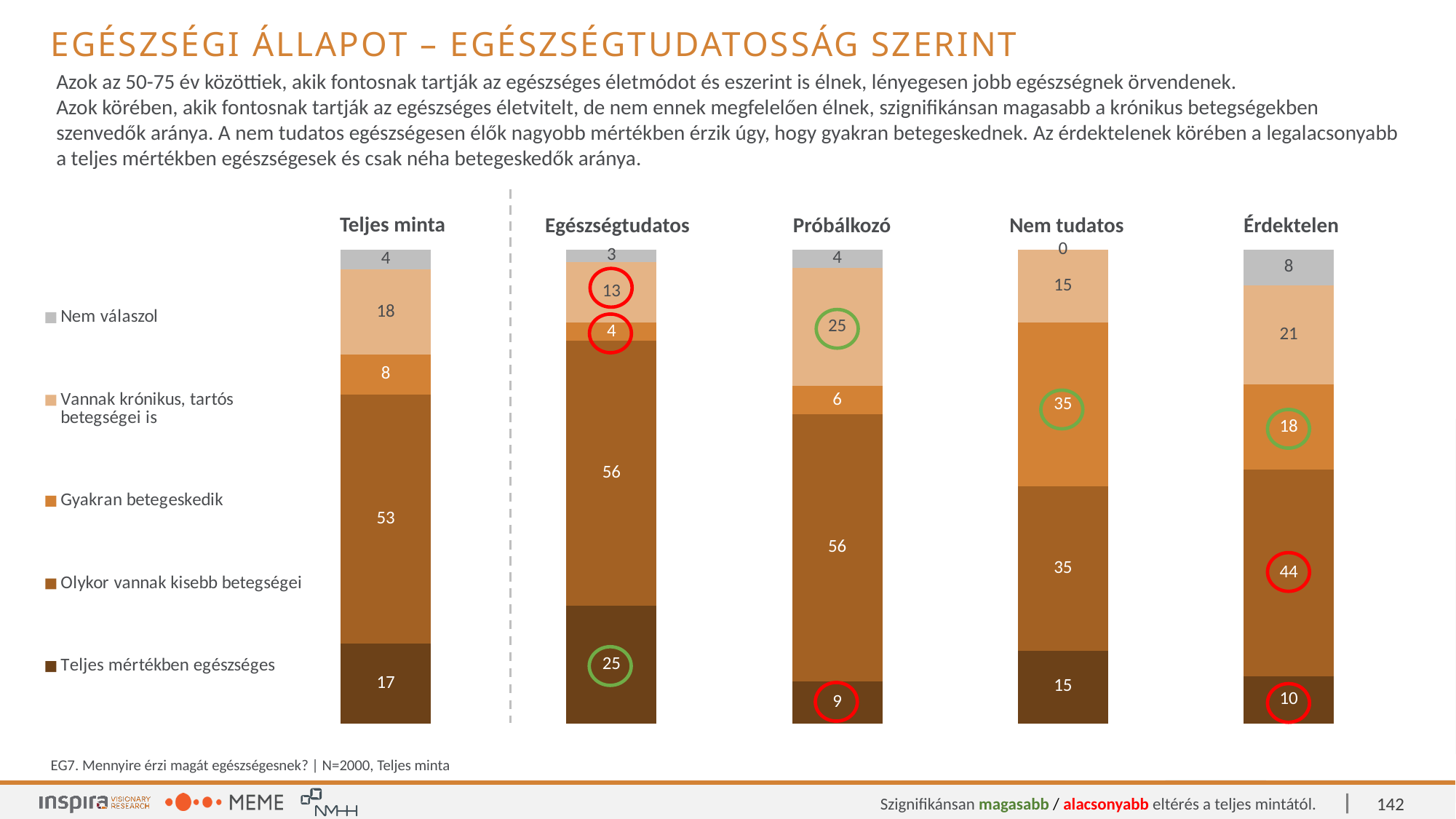
Which group has the highest value for "Teljes mértékben egészséges"? Egészségtudatos What is the value for "Gyakran betegeskedik" in the Nem tudatos bar? 35 What is the value for "Vannak krónikus, tartós betegségei is" in the Próbálkozó bar? 25 What is the total of the Nem tudatos stacked bar? 100 How many series does the legend list? 5 What is the value for "Olykor vannak kisebb betegségei" in the Teljes minta bar? 53 What is the value for "Teljes mértékben egészséges" in the Egészségtudatos bar? 25 What is the difference between the "Olykor vannak kisebb betegségei" values for Érdektelen and Teljes minta? 9 What kind of chart is shown on the slide? Stacked bar chart Which group has the lowest value for "Nem válaszol"? Nem tudatos Which is larger: the "Gyakran betegeskedik" value for Érdektelen or for Próbálkozó? Érdektelen How many groups (bars) are shown in the chart? 5